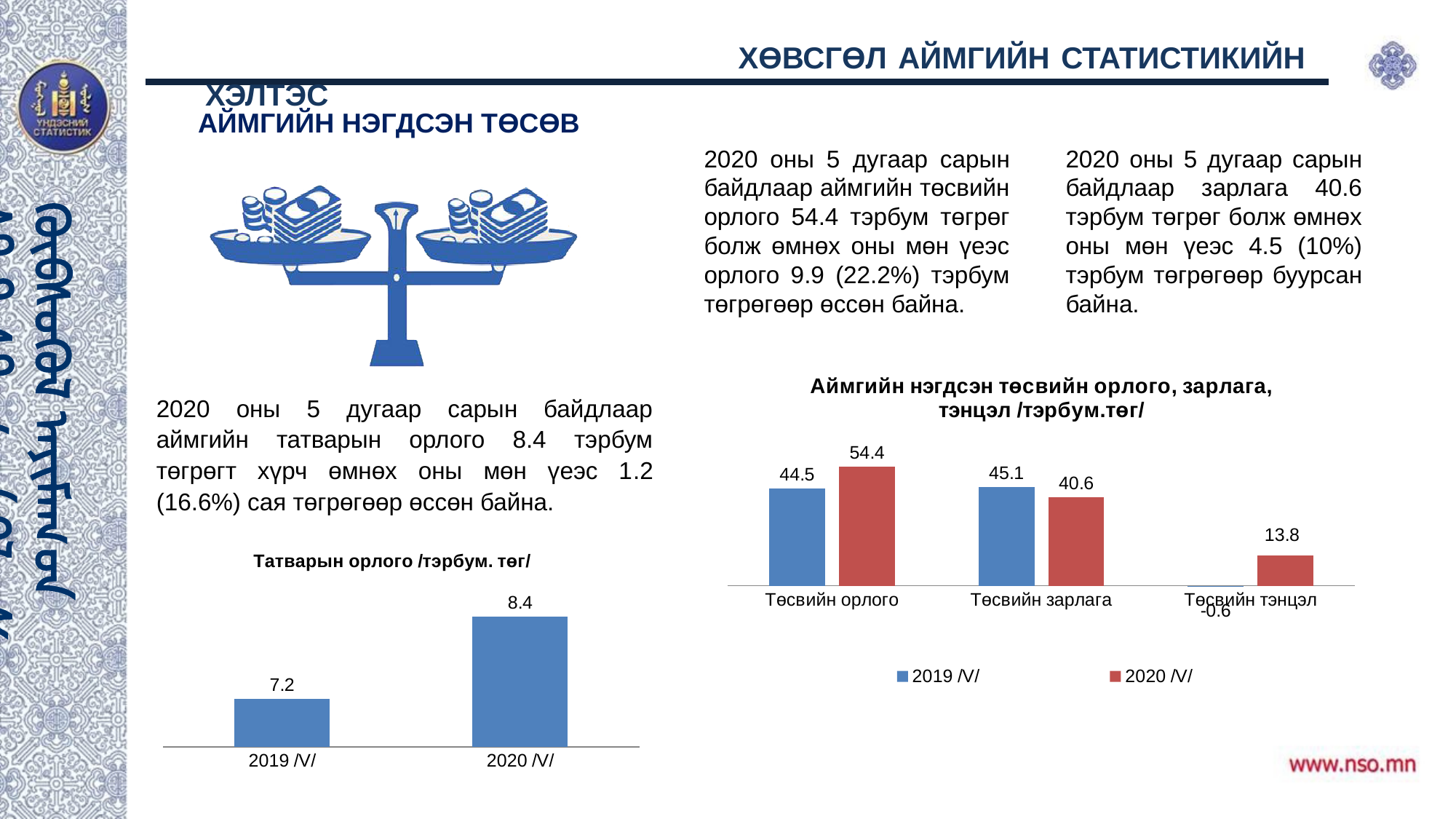
In the chart titled 'Татварын орлого /тэрбум. төг/', what is the value for 2019 /V/? 7.2 In the chart titled 'Аймгийн нэгдсэн төсвийн орлого, зарлага, тэнцэл /тэрбум.төг/', what is the 2019 /V/ value for Төсвийн зарлага? 45.1 In the chart titled 'Татварын орлого /тэрбум. төг/', what is the difference between the 2020 /V/ and 2019 /V/ values? 1.2 What kind of chart is the chart titled 'Аймгийн нэгдсэн төсвийн орлого, зарлага, тэнцэл /тэрбум.төг/'? bar chart In the chart titled 'Аймгийн нэгдсэн төсвийн орлого, зарлага, тэнцэл /тэрбум.төг/', what is the 2020 /V/ value for Төсвийн орлого? 54.4 In the chart titled 'Аймгийн нэгдсэн төсвийн орлого, зарлага, тэнцэл /тэрбум.төг/', how many series does the legend list? 2 In the chart titled 'Аймгийн нэгдсэн төсвийн орлого, зарлага, тэнцэл /тэрбум.төг/', which category has the highest 2020 /V/ value? Төсвийн орлого In the chart titled 'Аймгийн нэгдсэн төсвийн орлого, зарлага, тэнцэл /тэрбум.төг/', what is the 2019 /V/ value for Төсвийн тэнцэл? -0.6 In the chart titled 'Татварын орлого /тэрбум. төг/', what is the value for 2020 /V/? 8.4 In the chart titled 'Аймгийн нэгдсэн төсвийн орлого, зарлага, тэнцэл /тэрбум.төг/', what is the difference between the 2019 /V/ and 2020 /V/ values for Төсвийн зарлага? 4.5 In the chart titled 'Татварын орлого /тэрбум. төг/', do the values rise or fall from 2019 /V/ to 2020 /V/? rise In the chart titled 'Татварын орлого /тэрбум. төг/', how many bars are plotted? 2